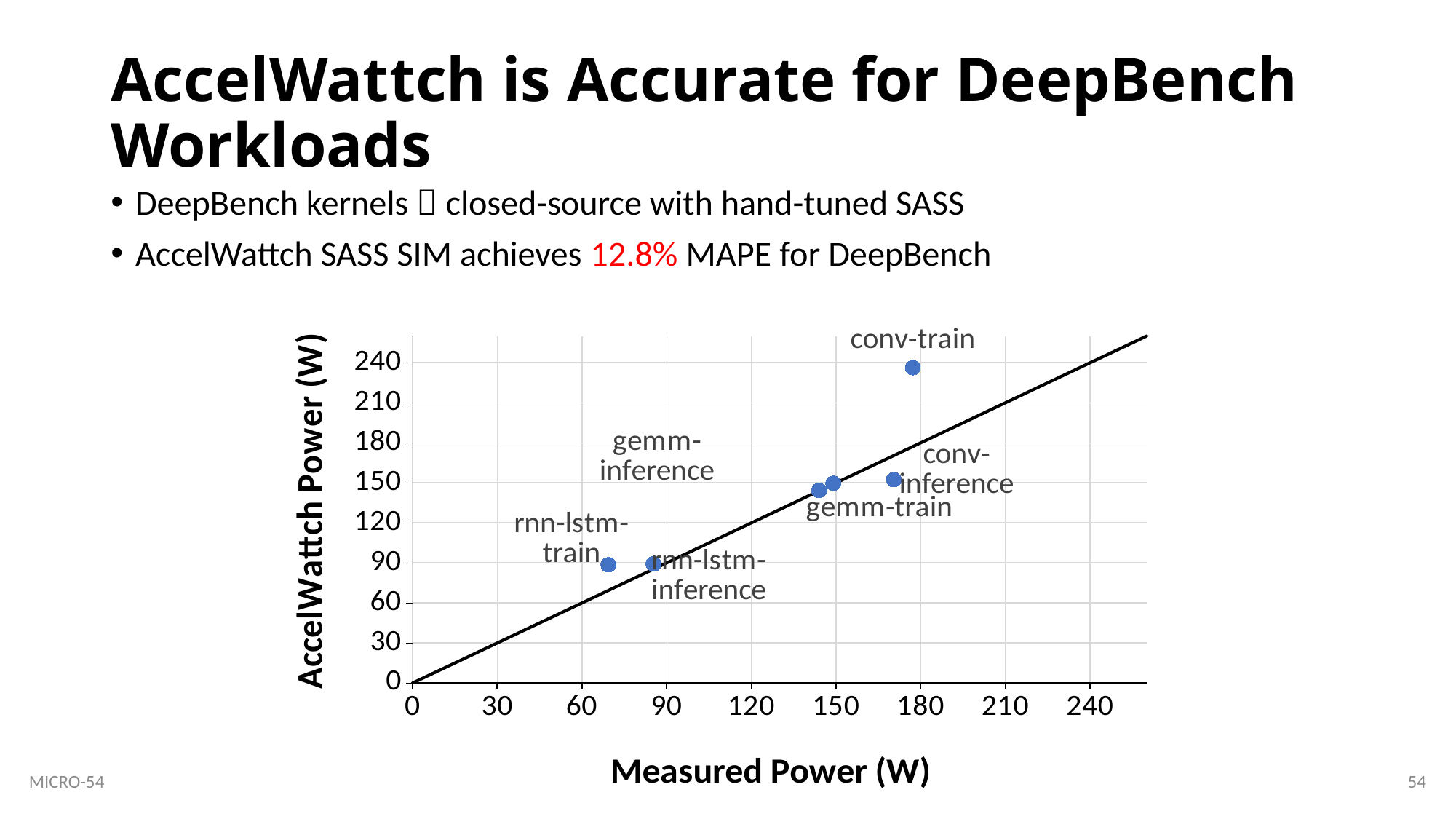
Is the Measured Power for rnn-lstm-train greater or less than 90? less Is the AccelWattch Power for conv-train greater or less than 210? greater How many labeled data points are plotted on the chart? 6 Which has a higher Measured Power, rnn-lstm-train or rnn-lstm-inference? rnn-lstm-inference Which has a higher AccelWattch Power, conv-train or conv-inference? conv-train What is the title of the x axis of the chart? Measured Power (W) Which workload has the lowest Measured Power on the chart? rnn-lstm-train Which workload has the highest AccelWattch Power on the chart? conv-train Is the Measured Power for conv-inference greater or less than 150? greater Do the plotted AccelWattch Power values generally rise or fall as Measured Power increases along the x axis? rise What kind of chart is shown on the slide? scatter chart